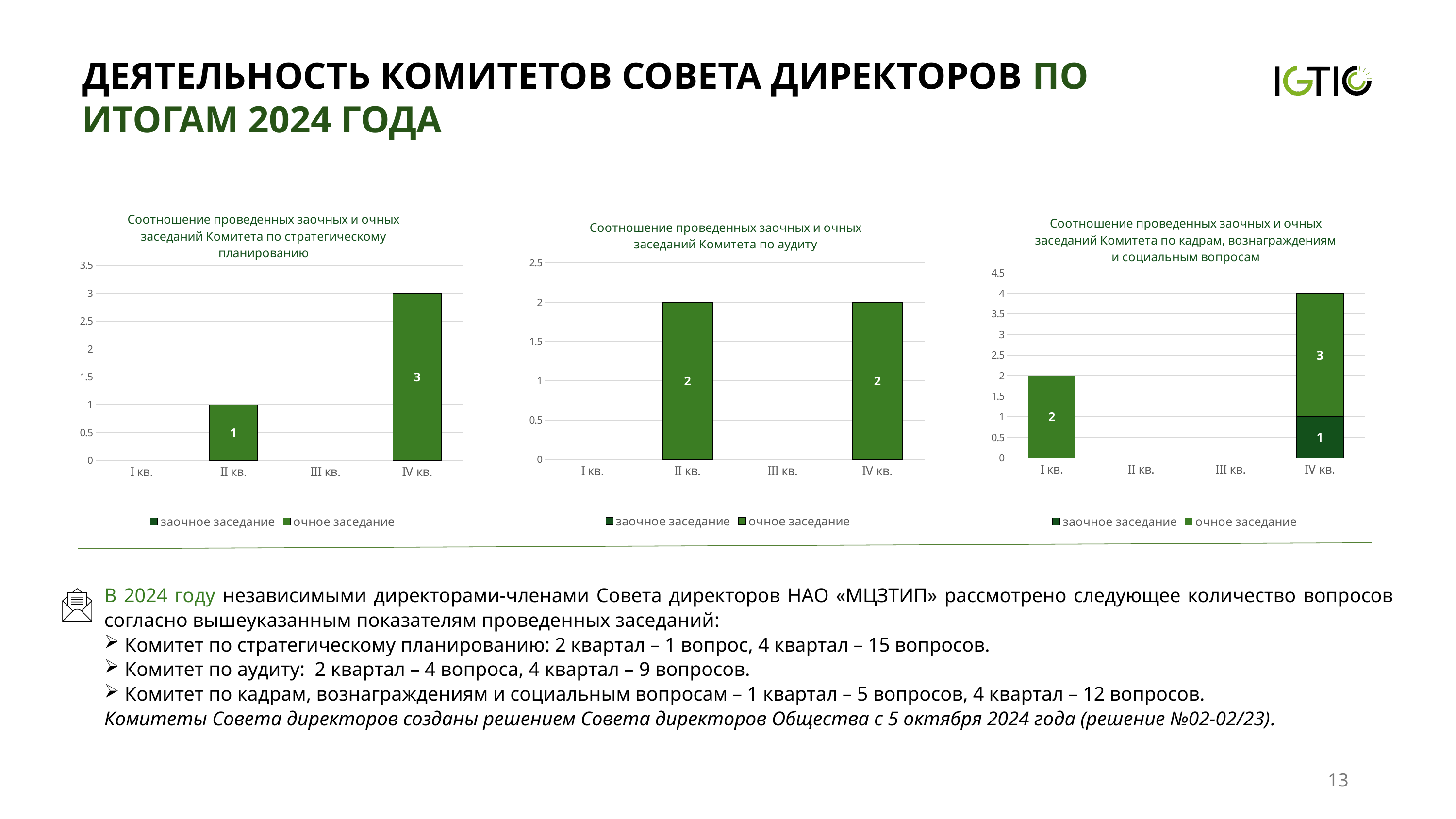
In the left chart (Комитет по стратегическому планированию), what is the value for II кв.? 1 In the middle chart (Комитет по аудиту), how many series does the legend list? 2 In the left chart (Комитет по стратегическому планированию), which is larger, the value for II кв. or IV кв.? IV кв. What type of chart is the right chart (Комитет по кадрам, вознаграждениям и социальным вопросам)? Stacked bar chart In the left chart (Комитет по стратегическому планированию), what is the difference between the values for IV кв. and II кв.? 2 How many quarter categories are shown on the x axis of the middle chart (Комитет по аудиту)? 4 In the right chart (Комитет по кадрам, вознаграждениям и социальным вопросам), what is the value of заочное заседание for IV кв.? 1 In the right chart (Комитет по кадрам, вознаграждениям и социальным вопросам), which quarter has the highest total? IV кв. In the middle chart (Комитет по аудиту), what is the value for II кв.? 2 In the left chart (Комитет по стратегическому планированию), what is the value for IV кв.? 3 In the right chart (Комитет по кадрам, вознаграждениям и социальным вопросам), what is the value of очное заседание for IV кв.? 3 In the right chart (Комитет по кадрам, вознаграждениям и социальным вопросам), what is the total of the stacked bar for IV кв.? 4